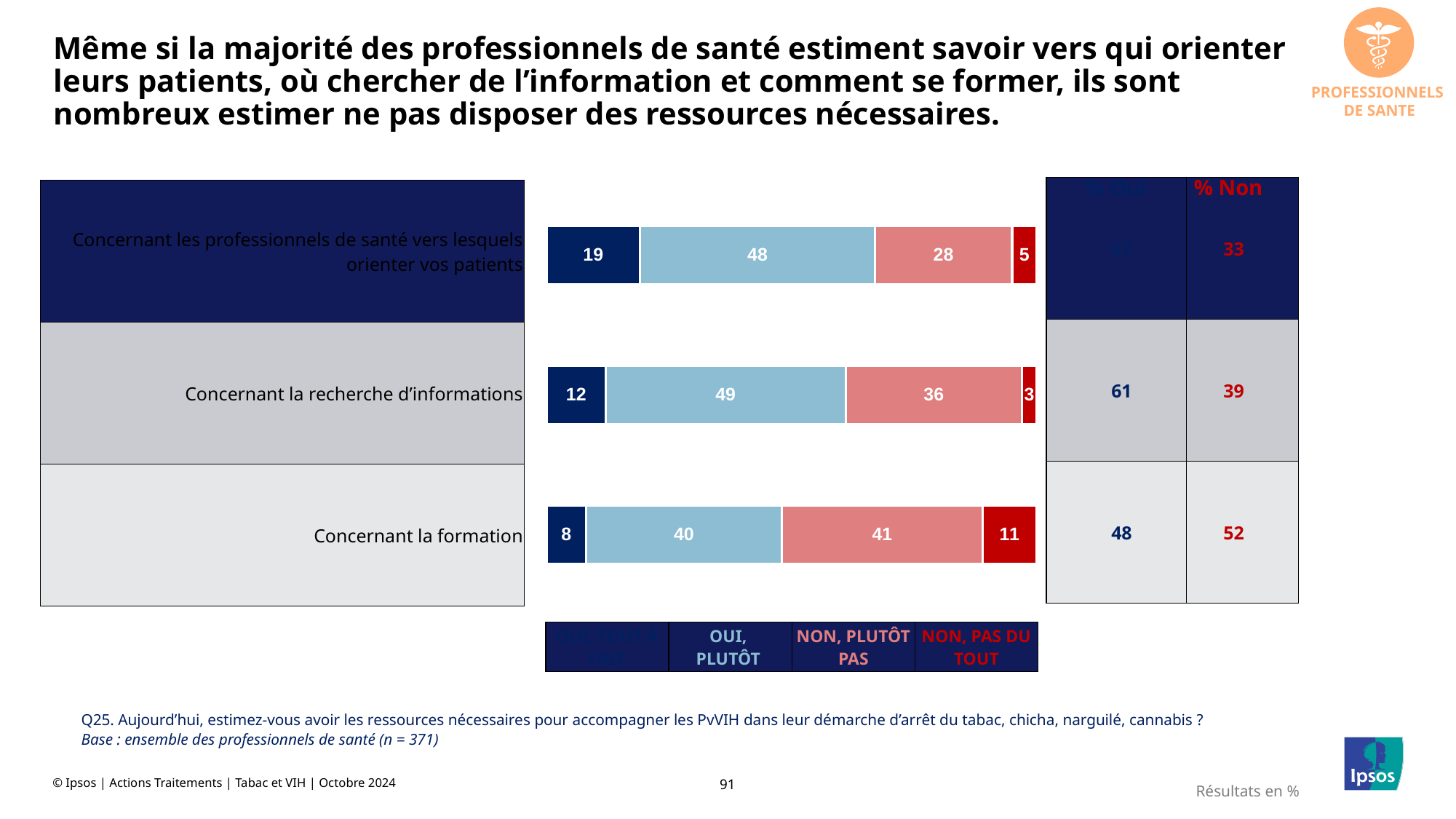
Which category has the lowest value for the first (dark blue) segment? Concernant la formation Which is larger: the 'NON, PLUTÔT PAS' value for 'Concernant la formation' or for 'Concernant la recherche d'informations'? Concernant la formation What is the '% Non' value shown for 'Concernant la formation'? 52 What type of chart is shown on the slide? stacked bar chart What is the total of the two 'Non' segments (NON, PLUTÔT PAS and NON, PAS DU TOUT) for 'Concernant la recherche d'informations'? 39 How many categories (rows) does the chart show? 3 What is the value of the 'NON, PAS DU TOUT' segment for 'Concernant la formation'? 11 What is the difference between the 'OUI, PLUTÔT' values for 'Concernant la recherche d'informations' and 'Concernant la formation'? 9 What is the value of the 'NON, PLUTÔT PAS' segment for 'Concernant les professionnels de santé vers lesquels orienter vos patients'? 28 What is the '% Oui' value shown for 'Concernant la recherche d'informations'? 61 What is the value of the 'OUI, PLUTÔT' segment for 'Concernant la recherche d'informations'? 49 Which category has the highest 'NON, PLUTÔT PAS' value? Concernant la formation